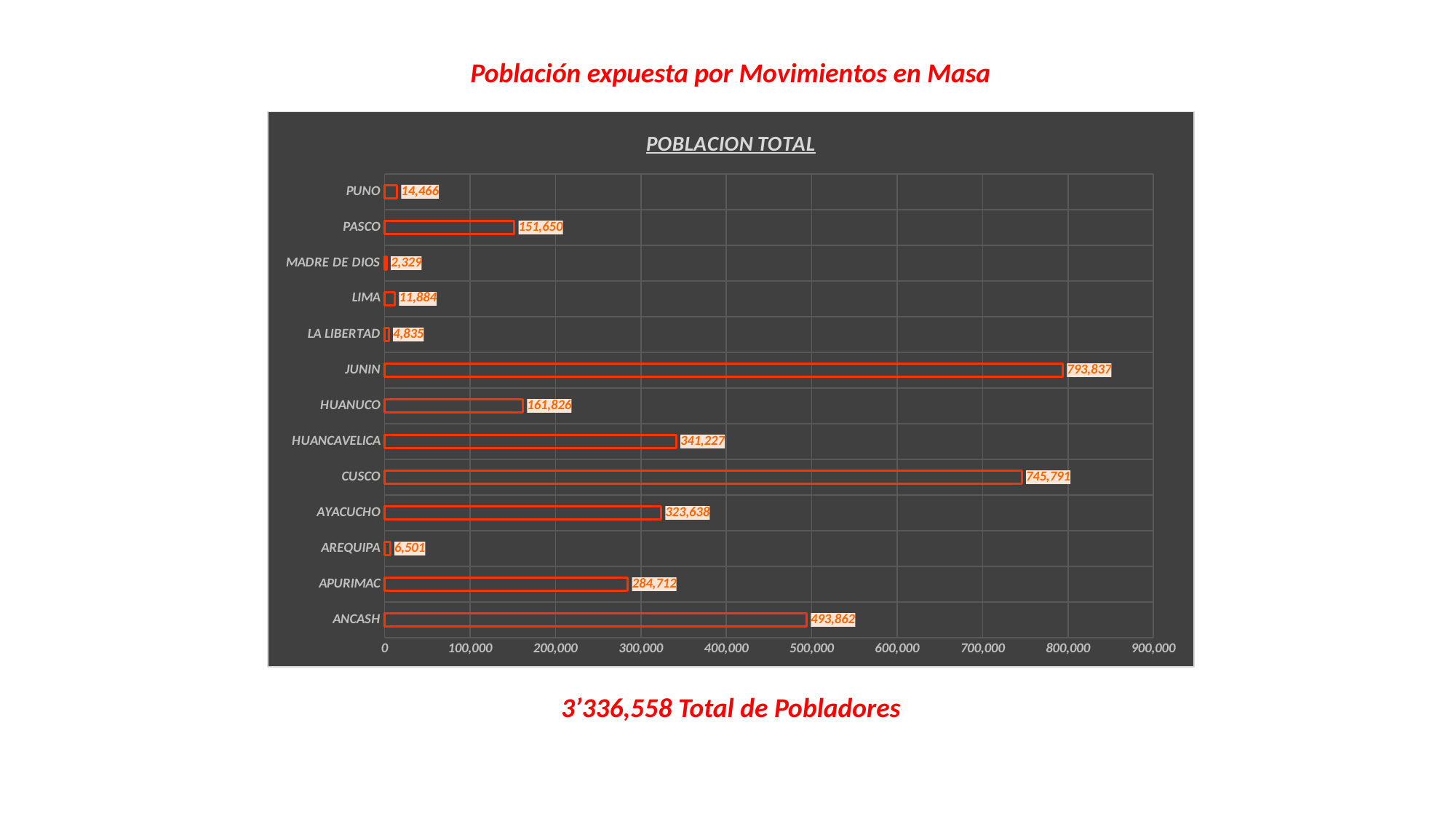
How many categories are shown in the chart? 13 What is the value for MADRE DE DIOS? 2,329 What is the value for ANCASH? 493,862 What is the value for JUNIN? 793,837 Which category has the highest value? JUNIN What is the difference between the values for HUANCAVELICA and AYACUCHO? 17,589 Is the value for ANCASH greater or less than 400,000? greater What is the difference between the values for JUNIN and CUSCO? 48,046 Which category has the lowest value? MADRE DE DIOS What kind of chart is shown on the slide? bar chart What is the value for HUANCAVELICA? 341,227 Which is larger, the value for HUANUCO or the value for PASCO? HUANUCO